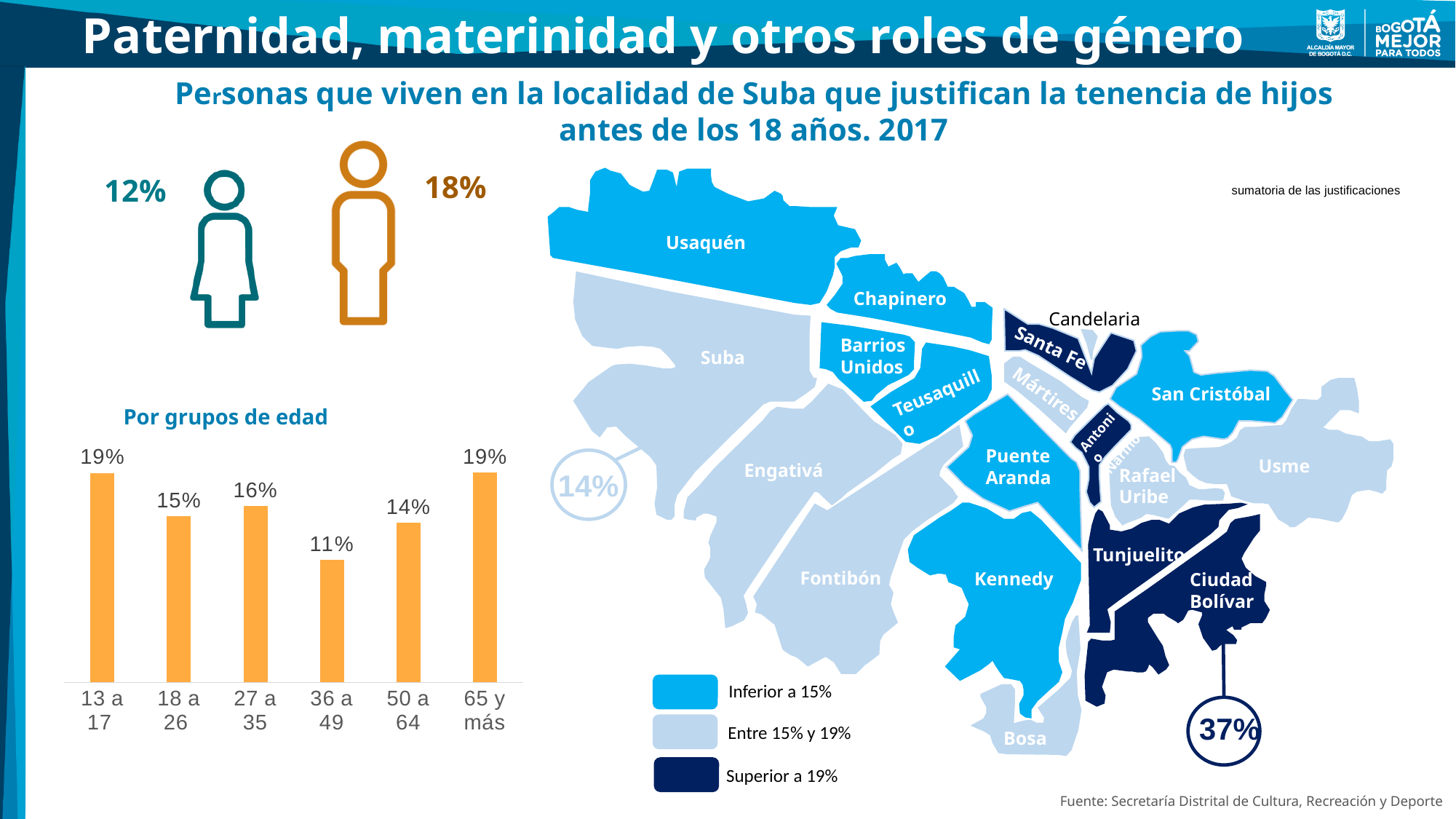
In the 'Por grupos de edad' chart, what is the value for the 65 y más age group? 19% What is the title of the bar chart on the left of the slide? Por grupos de edad In the 'Por grupos de edad' chart, what is the difference between the 13 a 17 group and the 36 a 49 group? 8% In the 'Por grupos de edad' chart, which age group has the lowest value? 36 a 49 In the 'Por grupos de edad' chart, what is the value for the 36 a 49 age group? 11% In the 'Por grupos de edad' chart, what is the difference between the 27 a 35 group and the 50 a 64 group? 2% How many age groups are shown in the 'Por grupos de edad' chart? 6 In the 'Por grupos de edad' chart, which is larger, the value for 27 a 35 or the value for 18 a 26? 27 a 35 What kind of chart is the 'Por grupos de edad' chart? Bar chart In the 'Por grupos de edad' chart, what is the value for the 50 a 64 age group? 14% In the 'Por grupos de edad' chart, what is the value for the 18 a 26 age group? 15%